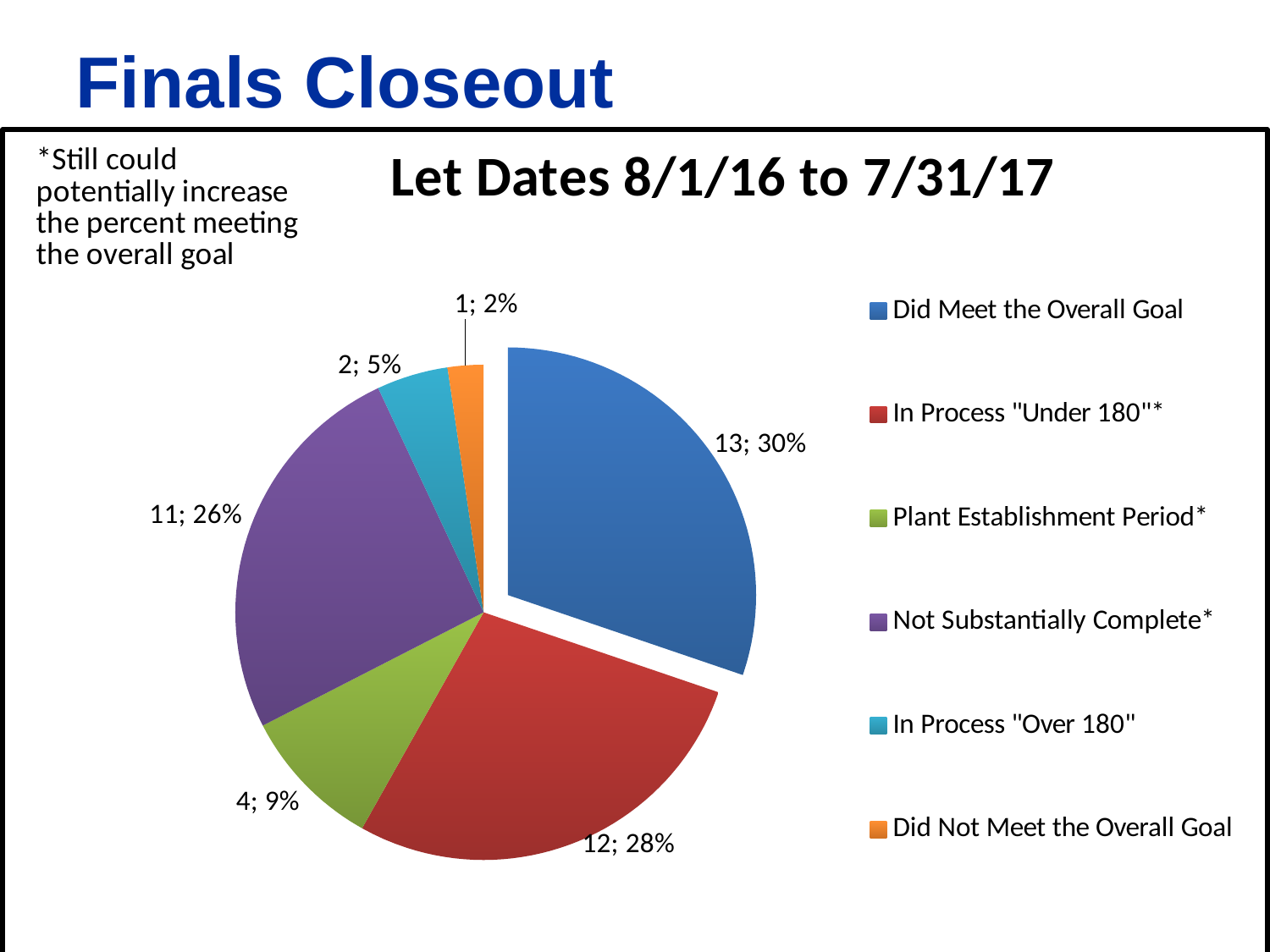
What kind of chart is shown on the slide? Pie chart What is the count for "Not Substantially Complete*"? 11 What percentage share does "Did Meet the Overall Goal" have? 30% What is the count for "Did Meet the Overall Goal"? 13 Which is larger, the count for "Not Substantially Complete*" or the count for "Plant Establishment Period*"? Not Substantially Complete* What percentage share does "Plant Establishment Period*" have? 9% How many categories does the legend list? 6 What colour is the slice for "In Process "Over 180""? Teal Which category has the smallest slice? Did Not Meet the Overall Goal What is the difference in count between "Did Meet the Overall Goal" and "In Process "Under 180"*"? 1 Which category has the largest slice? Did Meet the Overall Goal What is the title of the chart? Let Dates 8/1/16 to 7/31/17